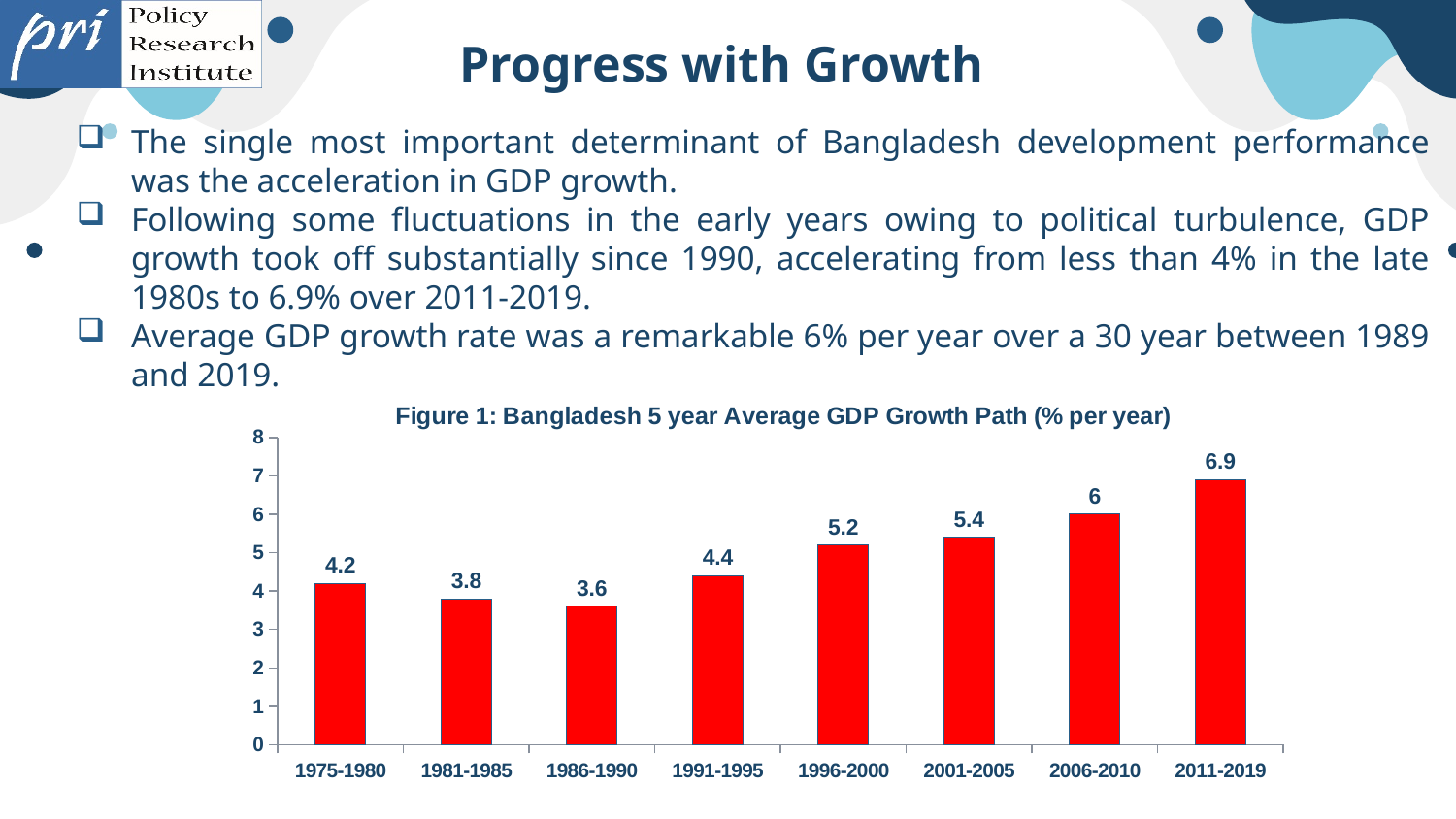
What kind of chart is shown on the slide? bar chart What is the title of the chart? Figure 1: Bangladesh 5 year Average GDP Growth Path (% per year) Which is larger, the value for 1981-1985 or the value for 1991-1995? 1991-1995 What is the value for 1996-2000? 5.2 Which period has the lowest average GDP growth? 1986-1990 How many periods are shown on the x axis? 8 Which period has the highest average GDP growth? 2011-2019 What value is shown for the 2006-2010 period? 6 What is the difference between the values for 2011-2019 and 1986-1990? 3.3 What is the average GDP growth rate shown for 1975-1980? 4.2 Is the value for 2001-2005 greater or less than 5? greater From 1991-1995 onward, do the values rise or fall along the x axis? rise